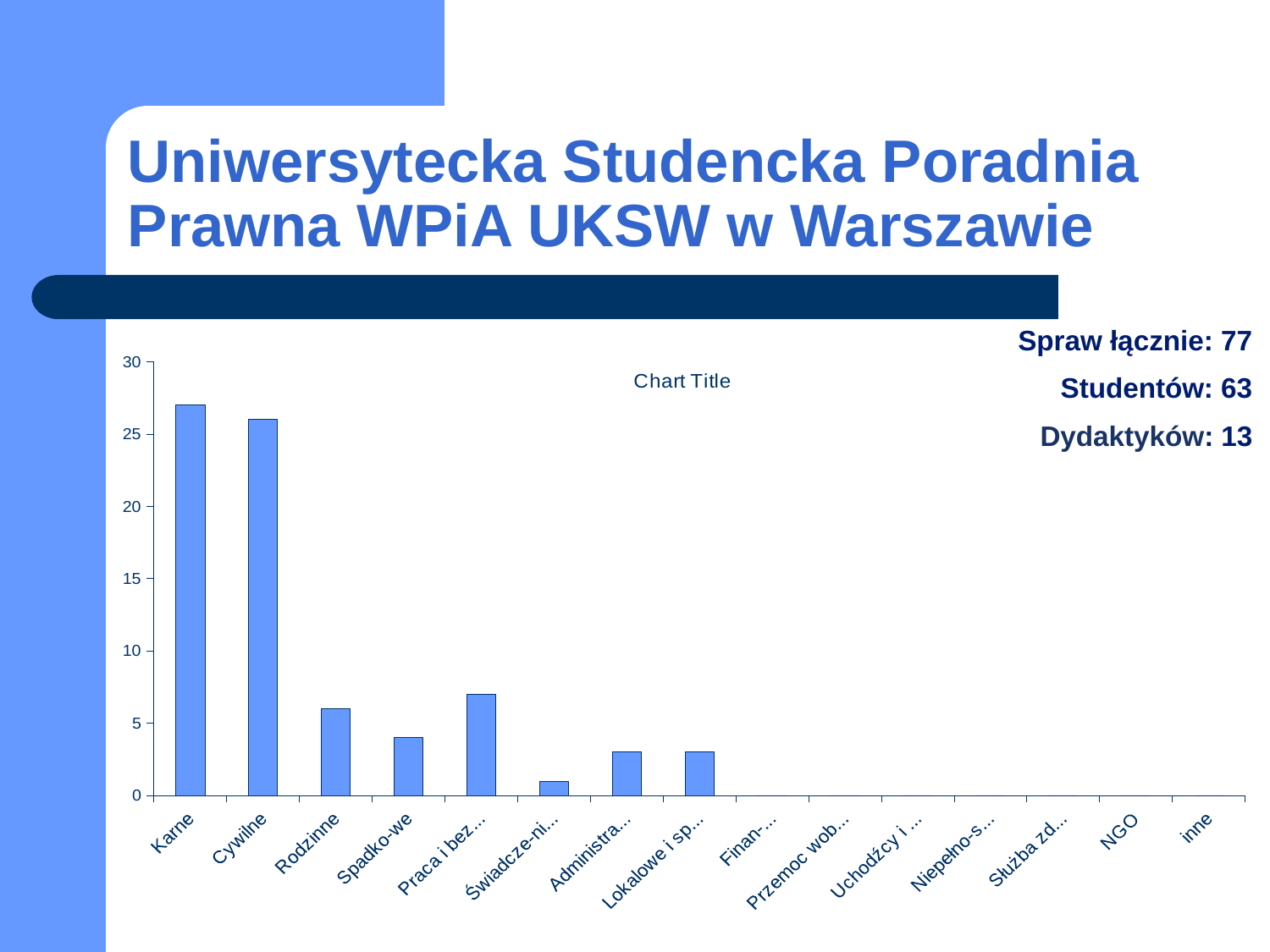
Which category has the tallest bar in the chart? Karne Is the value for Rodzinne greater or less than 5? greater Is the value for Administra... greater or less than 5? less Which is larger, the value for Rodzinne or the value for Spadko-we? Rodzinne Is the value for Karne greater or less than 30? less What kind of chart is shown on the slide? bar chart What is the title shown on the chart? Chart Title What is the value for NGO in the chart? 0 How many categories are shown on the x axis of the chart? 15